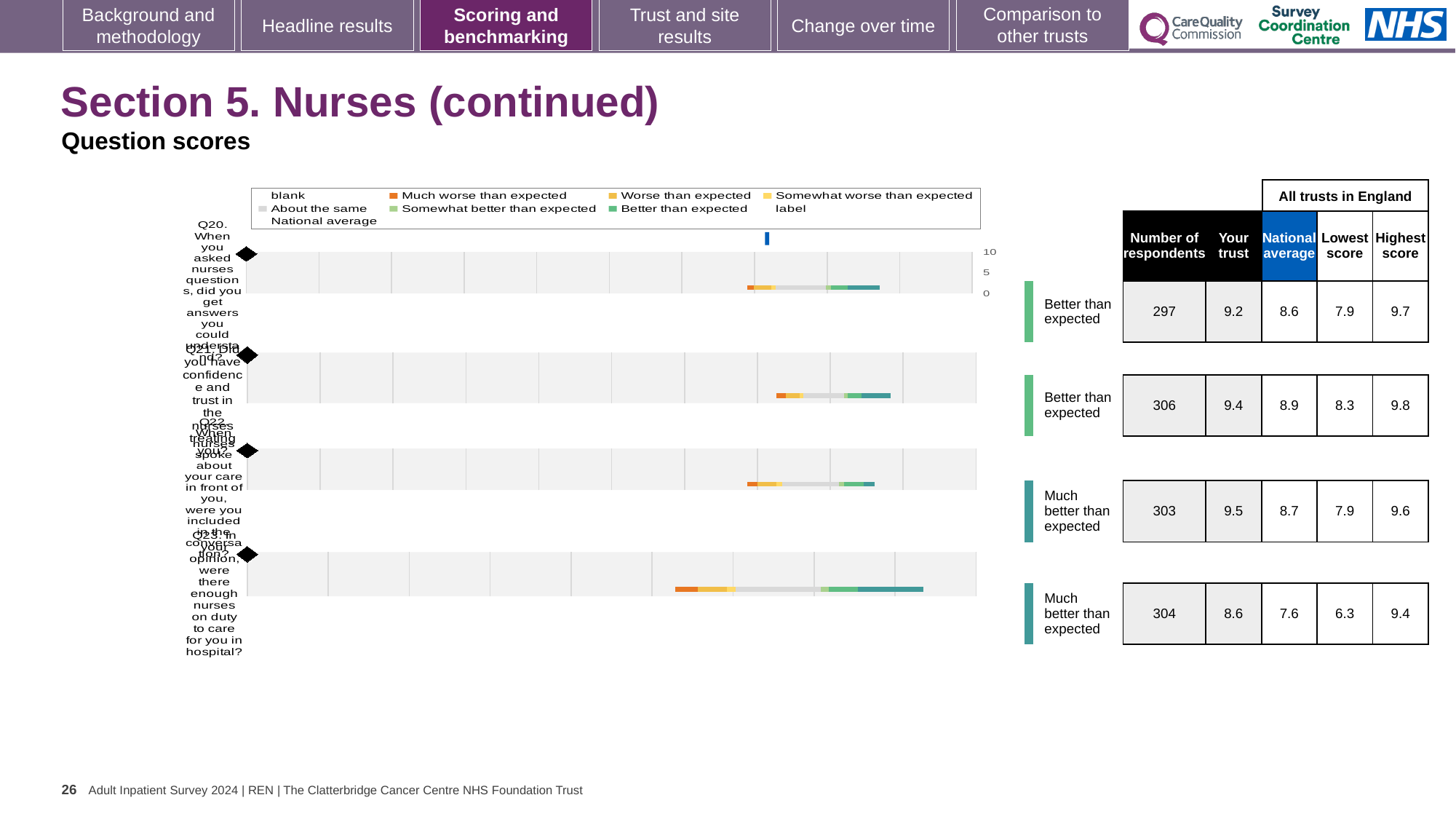
How many respondents answered Q22 (were you included in the conversation when nurses spoke about your care)? 303 For Q21, which is larger: the 'Your trust' score or the national average? Your trust Which question has the lowest 'Your trust' score? Q23 Which question has the highest 'Your trust' score? Q22 What benchmarking rating is shown for Q22? Much better than expected For Q23, what is the difference between the highest score and the lowest score among all trusts in England? 3.1 What is the 'Your trust' score for Q23 (were there enough nurses on duty to care for you in hospital)? 8.6 What is the national average score for Q21 (did you have confidence and trust in the nurses treating you)? 8.9 How many questions are plotted on the chart? 4 What kind of chart is used to show the question scores? Bar chart For Q20, how much higher is the 'Your trust' score than the national average? 0.6 What is the highest score among all trusts in England for Q21? 9.8